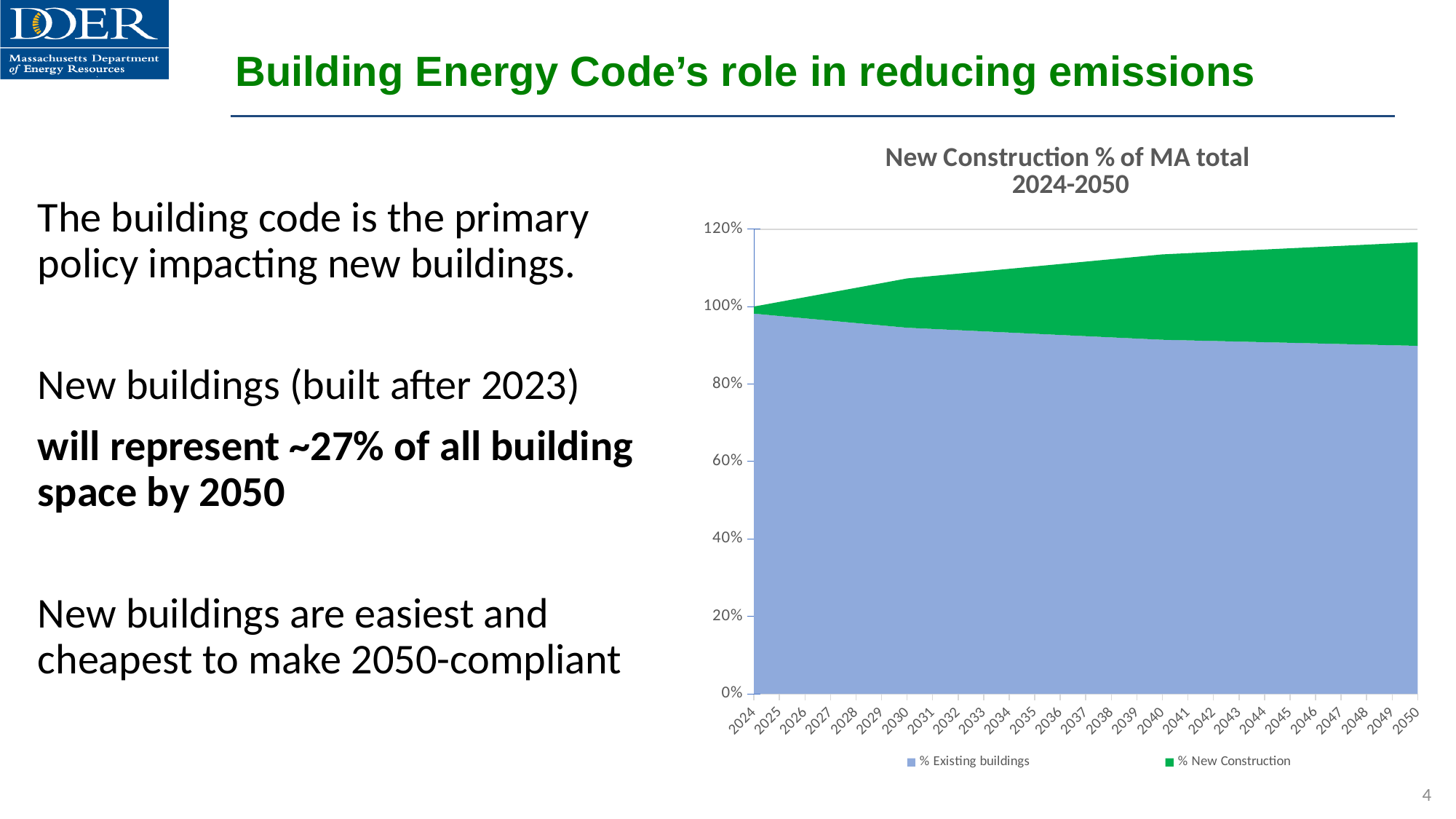
How many years are shown along the x axis of the chart? 27 Is the value for % New Construction in 2030 greater or less than 20%? less Is the value for % New Construction in 2050 greater or less than 20%? greater What is the title of the chart? New Construction % of MA total 2024-2050 Is the value for % Existing buildings in 2024 greater or less than 100%? less Does the % Existing buildings series rise or fall from 2024 to 2050? Fall What kind of chart is shown on the slide? Stacked area chart What are the two series named in the chart legend? % Existing buildings and % New Construction How many series does the chart's legend list? 2 In 2050, which series has the larger value, % Existing buildings or % New Construction? % Existing buildings Does the % New Construction series rise or fall from 2024 to 2050? Rise